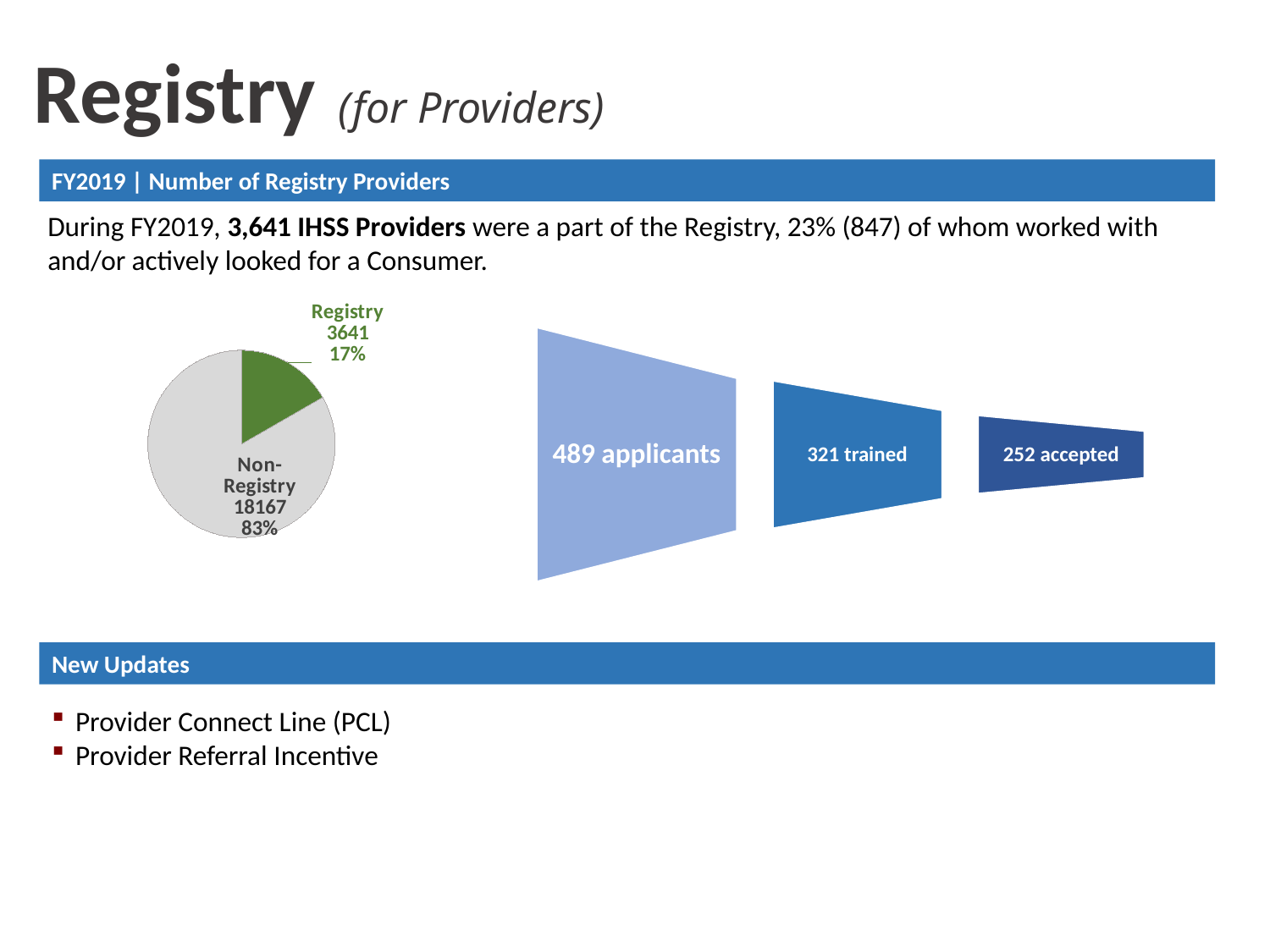
In the pie chart, what is the value for Registry? 3641 What kind of chart is shown on the left of the slide? pie chart In the funnel graphic on the right, how many applicants are shown in the first stage? 489 applicants In the pie chart, what is the difference between the Non-Registry and Registry values? 14526 In the funnel graphic on the right, what is the difference between the number trained and the number accepted? 69 In the pie chart, what is the value for Non-Registry? 18167 How many slices does the pie chart have? 2 In the pie chart, what colour is the Registry slice? green In the pie chart, which category has the largest slice? Non-Registry In the pie chart, which category has the smallest slice? Registry In the pie chart, what share of the pie does the Registry slice represent? 17% In the pie chart, what share of the pie does the Non-Registry slice represent? 83%